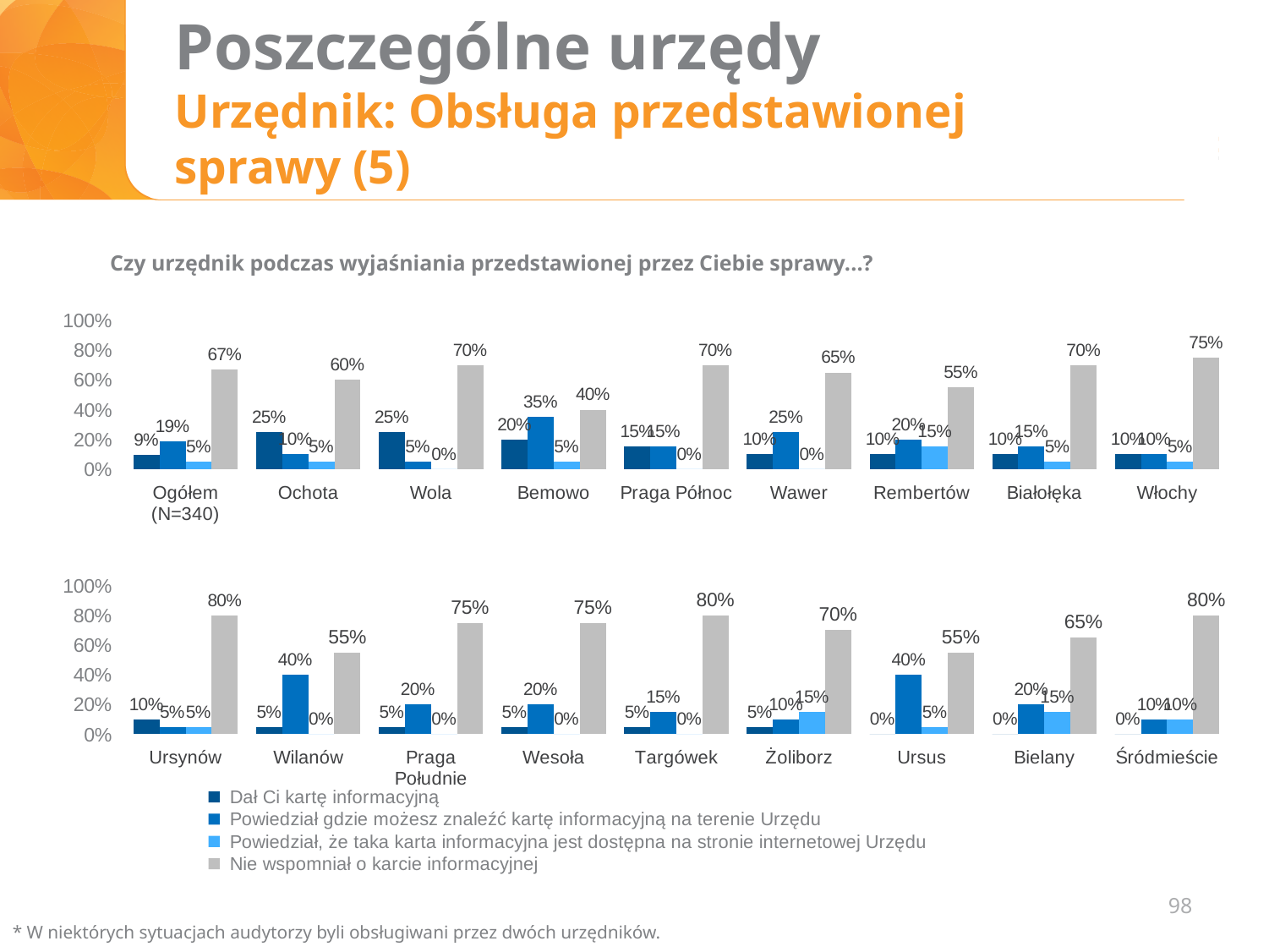
In the bottom chart, what is the value for 'Nie wspomniał o karcie informacyjnej' for Bielany? 65% In the top chart, what is the difference between the 'Nie wspomniał o karcie informacyjnej' values for Włochy and Bemowo? 35 percentage points In the top chart, what is the value for 'Nie wspomniał o karcie informacyjnej' for Ogółem (N=340)? 67% How many series does the legend list? 4 What type of chart is the top chart? Bar chart In the top chart, which category has the lowest value for 'Nie wspomniał o karcie informacyjnej'? Bemowo In the bottom chart, which is larger: the 'Powiedział gdzie możesz znaleźć kartę informacyjną na terenie Urzędu' value for Wilanów or for Targówek? Wilanów In the top chart, what is the value for 'Powiedział gdzie możesz znaleźć kartę informacyjną na terenie Urzędu' for Bemowo? 35% How many categories are shown on the x axis of the bottom chart? 9 In the bottom chart, is the 'Nie wspomniał o karcie informacyjnej' value for Ursynów greater or less than 60%? greater In the top chart, which district has the highest value for 'Nie wspomniał o karcie informacyjnej'? Włochy In the bottom chart, what is the value for 'Dał Ci kartę informacyjną' for Śródmieście? 0%